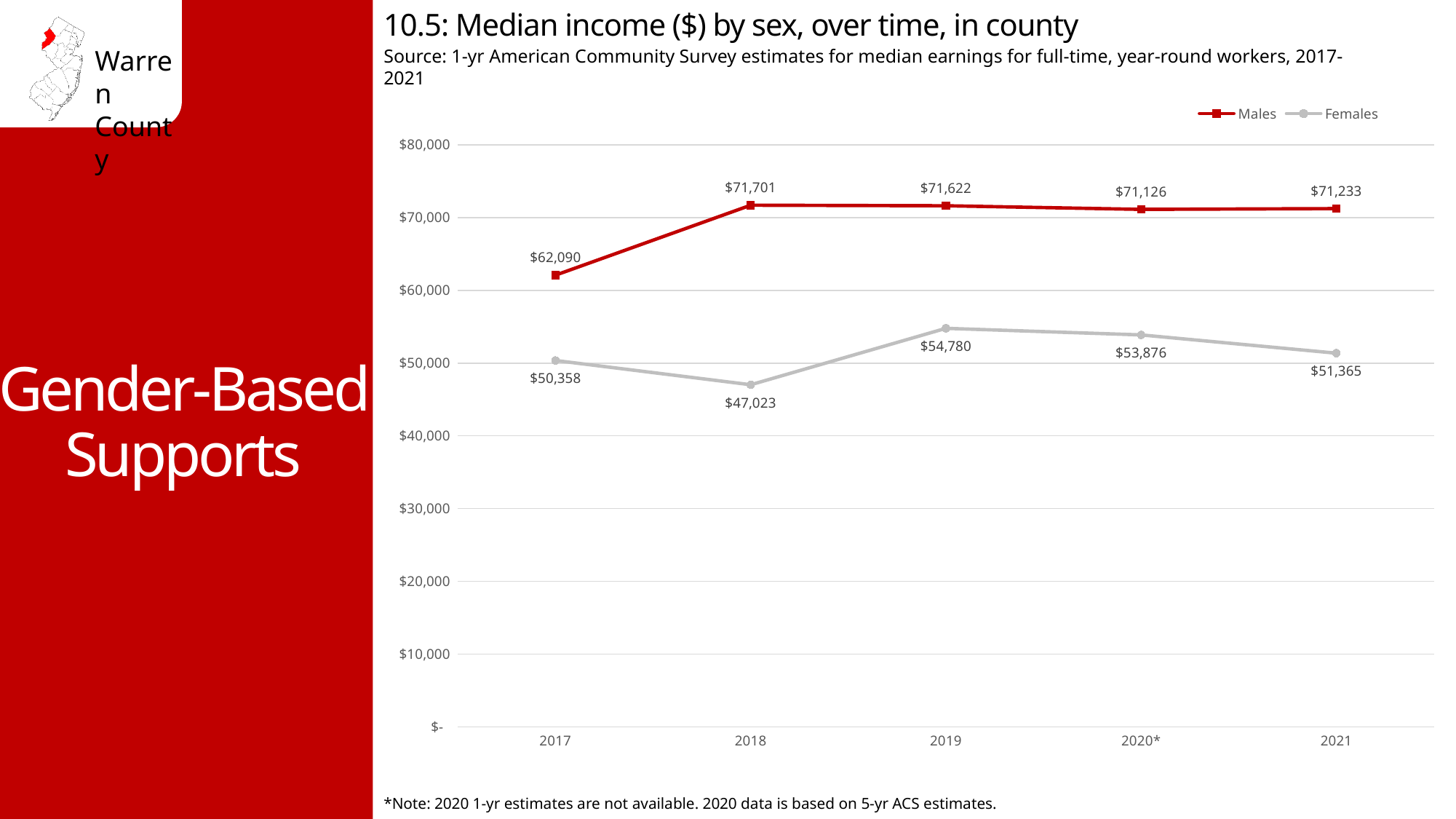
What was the median income for males in 2017? $62,090 What kind of chart is shown? Line chart What was the median income for females in 2021? $51,365 In which year was the median income for females lowest? 2018 Which was larger in 2020*: the median income for males or for females? Males How many series does the legend list? 2 In which year was the median income for males highest? 2018 Is the median income for females in 2019 greater or less than $50,000? greater How many years are shown on the x axis? 5 Did the median income for males rise or fall from 2017 to 2018? Rise What is the difference between the male and female median income in 2019? $16,842 What was the median income for females in 2018? $47,023